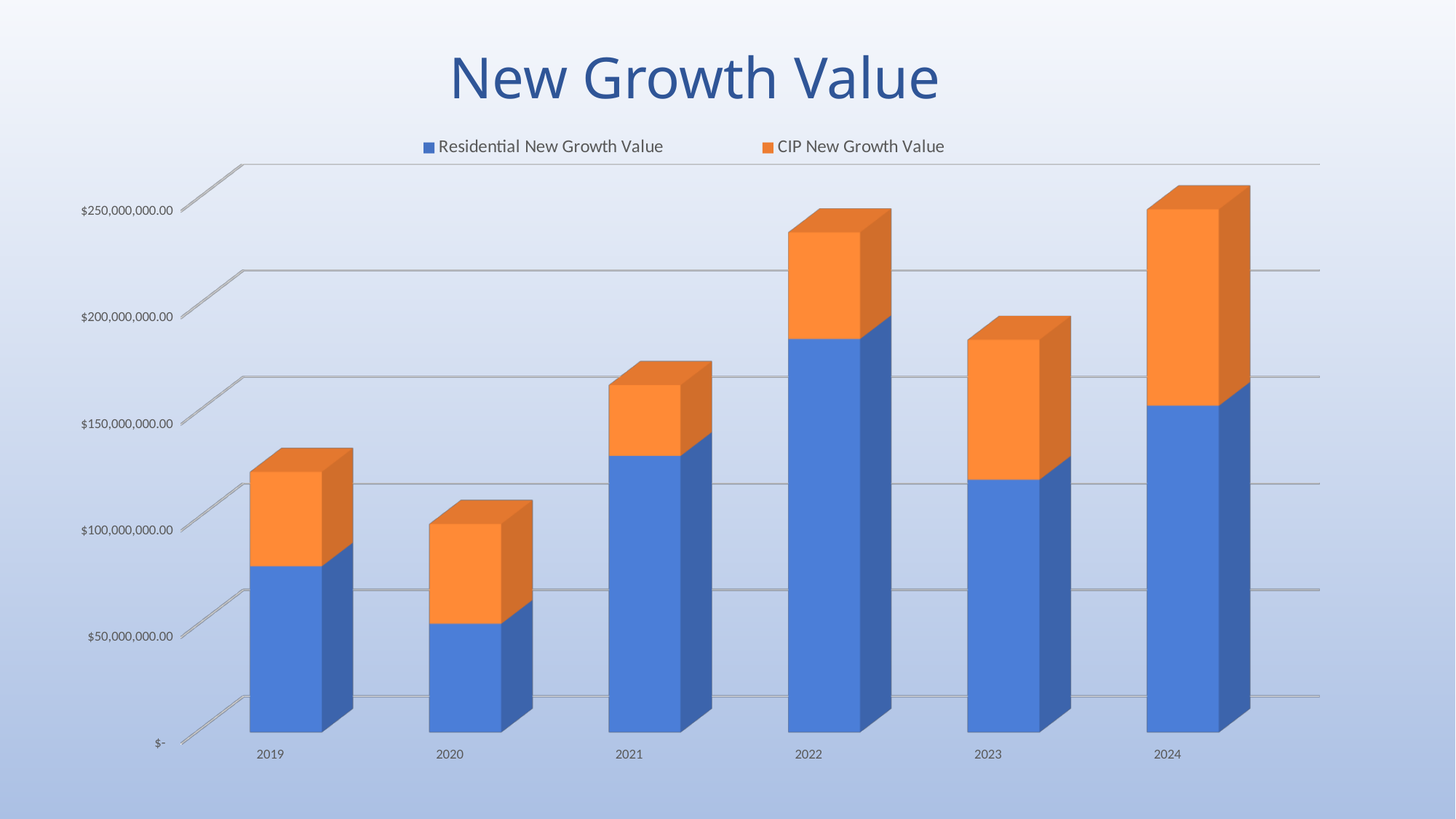
Which year has the largest CIP New Growth Value segment? 2024 Which year has the lowest total New Growth Value? 2020 Which year has the highest total New Growth Value? 2024 How many years are shown on the x axis? 6 What kind of chart is shown on the slide? Stacked bar chart Which series is shown in orange? CIP New Growth Value Is the total New Growth Value for 2022 greater or less than $200,000,000.00? greater Is the Residential New Growth Value for 2019 greater or less than $100,000,000.00? less How many series does the legend list? 2 What is the title of the chart? New Growth Value Which year has the larger total New Growth Value, 2022 or 2023? 2022 Which year has the highest Residential New Growth Value? 2022